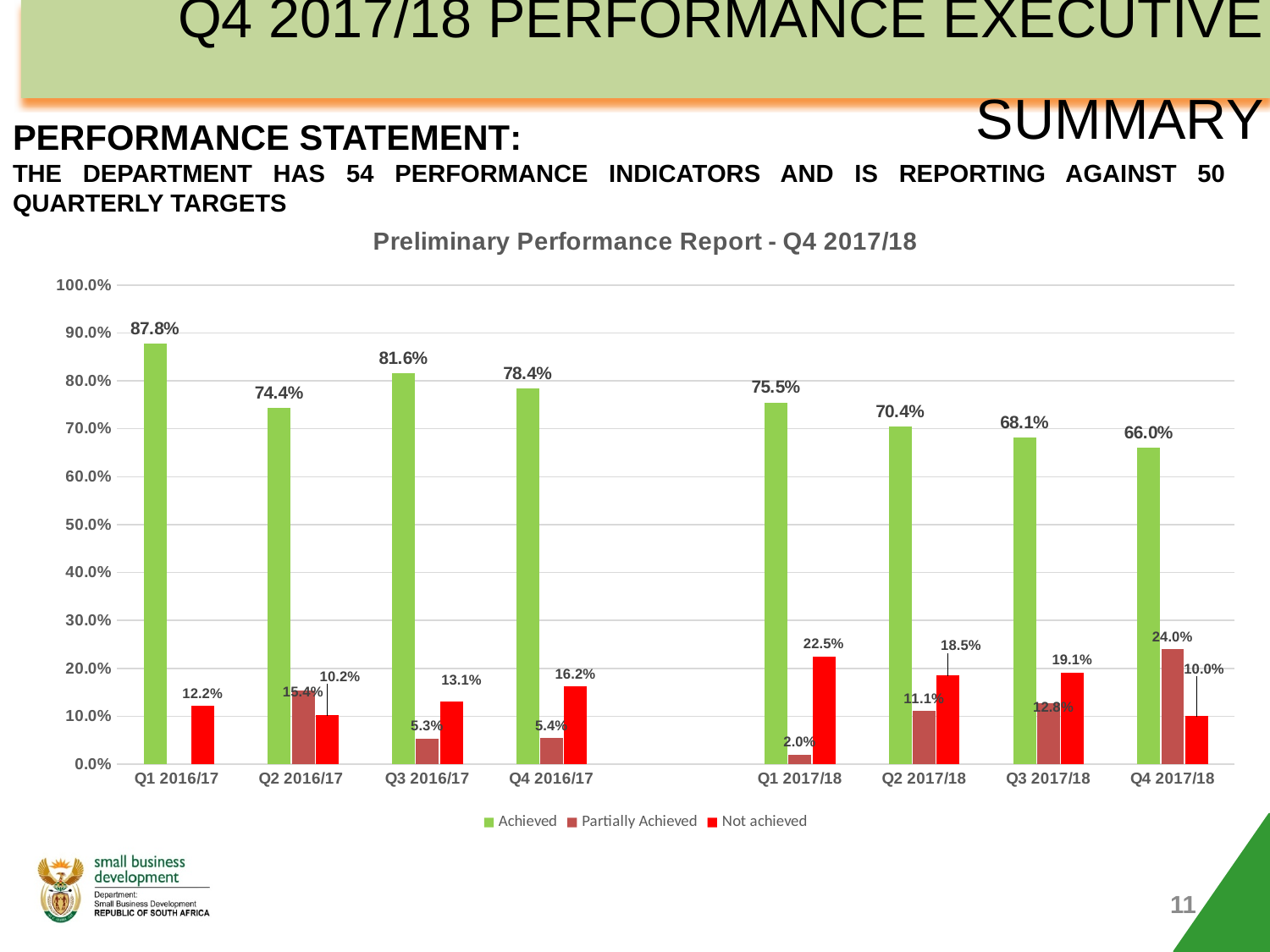
What is the Achieved value for Q1 2016/17? 87.8% What is the difference between the Achieved values for Q1 2016/17 and Q4 2017/18? 21.8% What is the Not achieved value for Q1 2017/18? 22.5% Which quarter has the highest Achieved value? Q1 2016/17 Do the Achieved values rise or fall from Q1 2017/18 to Q4 2017/18? fall Which quarter has the highest Not achieved value? Q1 2017/18 Which is larger, the Not achieved value for Q4 2016/17 or for Q3 2016/17? Q4 2016/17 Which quarter has the lowest Achieved value? Q4 2017/18 How many series does the legend list? 3 Is the Achieved value for Q3 2017/18 greater or less than 70.0%? less What is the Partially Achieved value for Q4 2017/18? 24.0% How many quarters are labelled on the x axis? 8